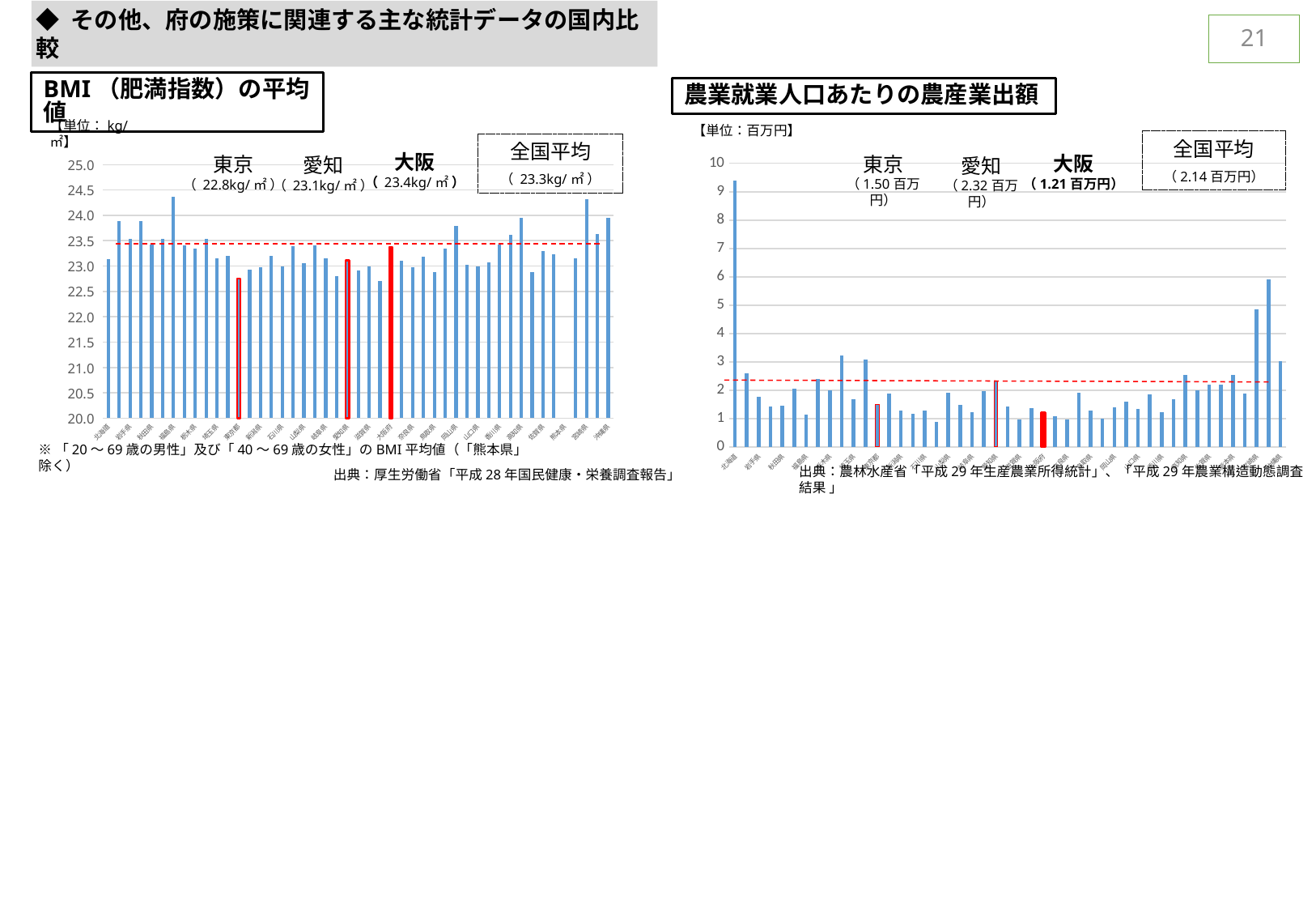
On the 農業就業人口あたりの農産業出額 chart, what is the 全国平均 value? 2.14百万円 On the BMI（肥満指数）の平均値 chart, what is the difference between the values for 大阪 and 東京? 0.6kg/㎡ On the 農業就業人口あたりの農産業出額 chart, what is the value for 愛知? 2.32百万円 On the 農業就業人口あたりの農産業出額 chart, what is the value for 大阪? 1.21百万円 On the BMI（肥満指数）の平均値 chart, which is larger, the value for 愛知 or the value for 東京? 愛知 On the 農業就業人口あたりの農産業出額 chart, is the value for 大阪 greater or less than 2? less On the BMI（肥満指数）の平均値 chart, what is the value for 大阪? 23.4kg/㎡ On the BMI（肥満指数）の平均値 chart, is the value for 東京 greater or less than 23.0? less On the BMI（肥満指数）の平均値 chart, what is the value for 東京? 22.8kg/㎡ On the BMI（肥満指数）の平均値 chart, what is the 全国平均 value? 23.3kg/㎡ On the 農業就業人口あたりの農産業出額 chart, what is the difference between the values for 愛知 and 大阪? 1.11百万円 What kind of chart is the 農業就業人口あたりの農産業出額 chart? bar chart